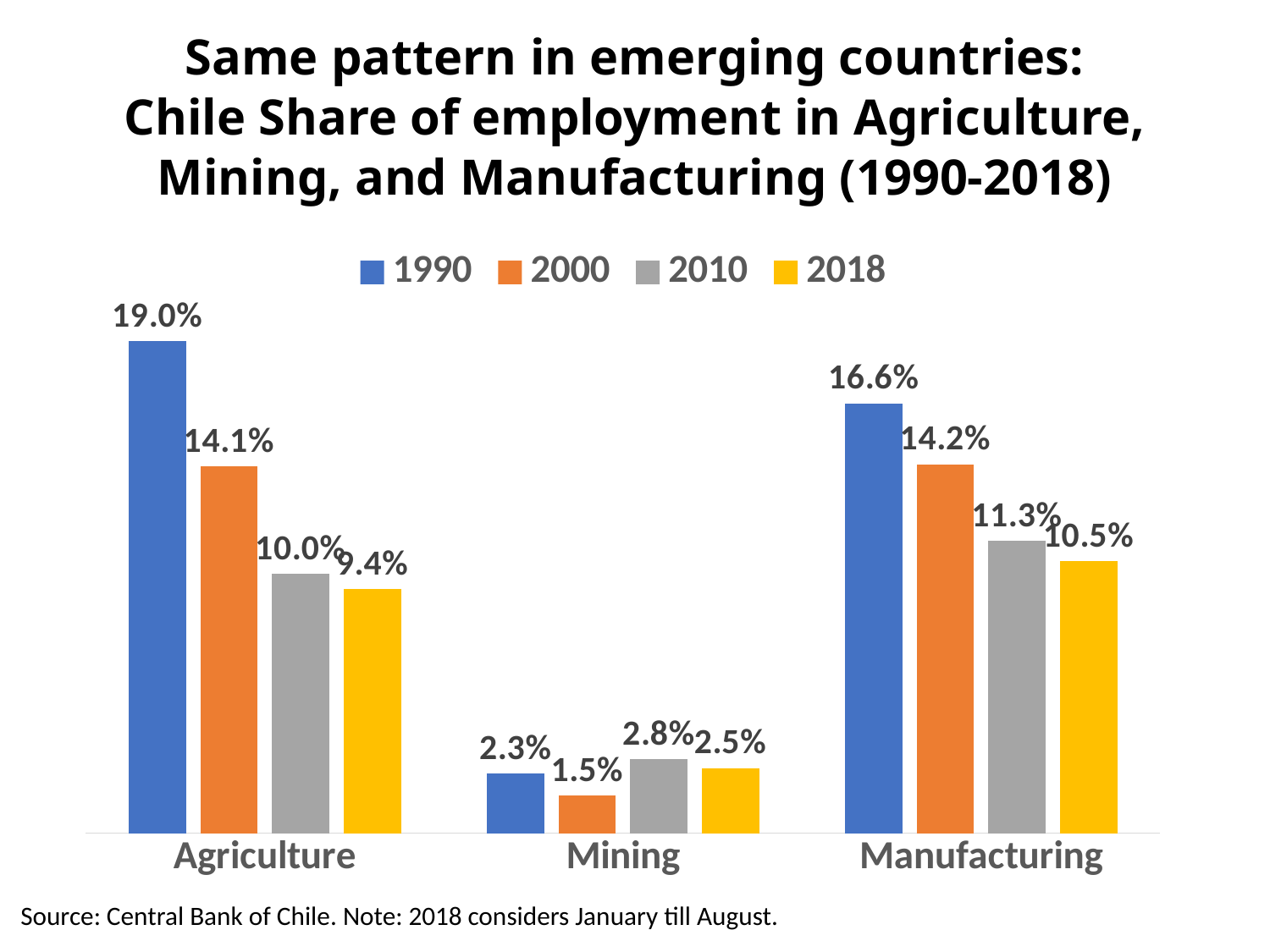
What kind of chart is shown on the slide? Bar chart Which colour represents the year 2018 in the legend? Yellow What is the share of employment in Mining in 2010? 2.8% How many series does the legend list? 4 What is the share of employment in Manufacturing in 2018? 10.5% What is the share of employment in Agriculture in 1990? 19.0% Which is larger, the Agriculture share in 2010 or the Manufacturing share in 2010? Manufacturing share in 2010 Which sector has the highest share of employment in 2000? Manufacturing What is the difference between the Agriculture share in 1990 and in 2018? 9.6% Which sector has the lowest share of employment in 1990? Mining Does the share of employment in Manufacturing rise or fall from 1990 to 2018? Fall How many sectors are shown on the x axis? 3